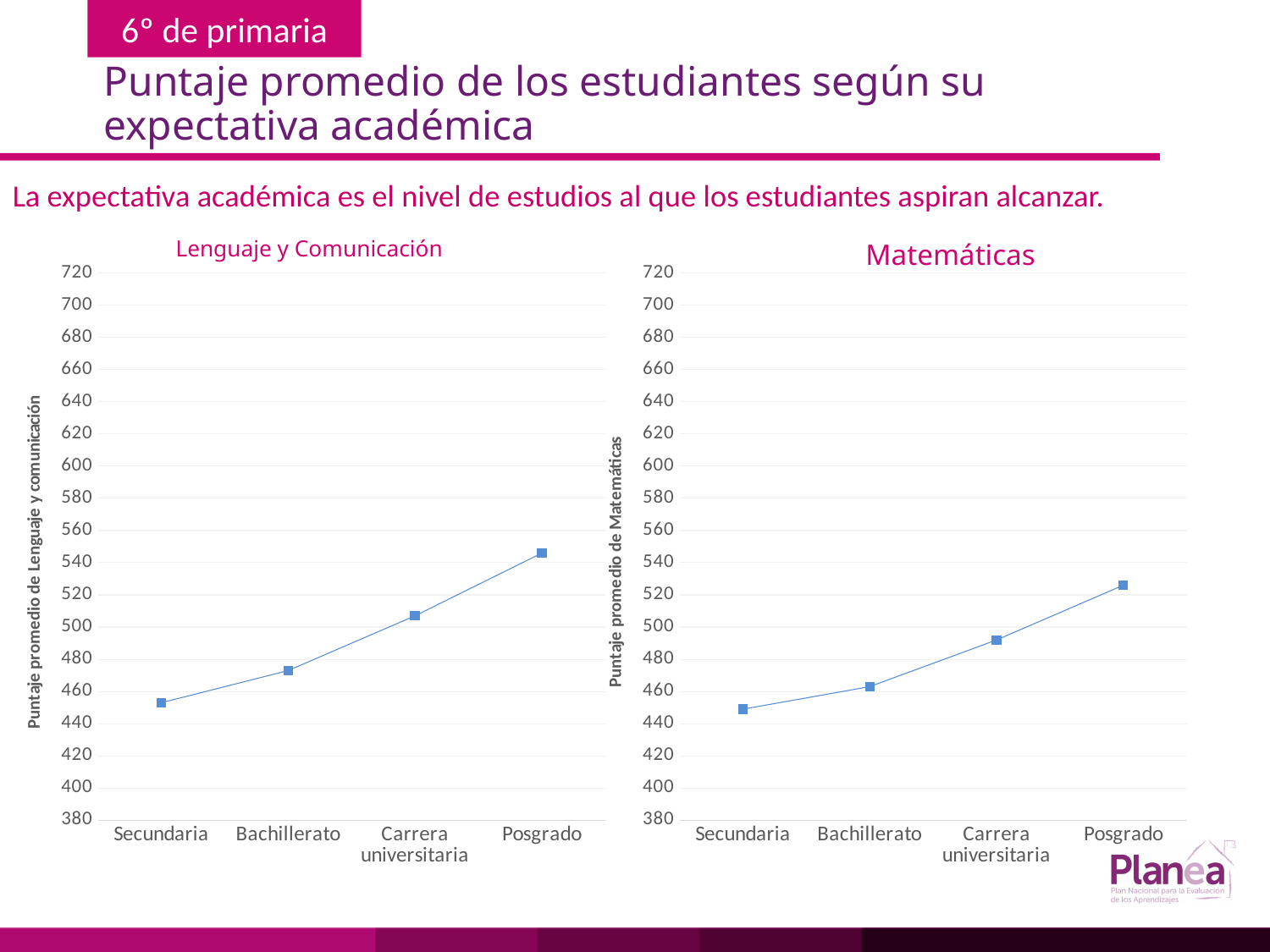
What kind of chart is the Lenguaje y Comunicación chart? line chart In the Matemáticas chart, is the value for Carrera universitaria greater or less than 480? greater What is the y-axis label of the Matemáticas chart? Puntaje promedio de Matemáticas In the Lenguaje y Comunicación chart, which category has the highest score? Posgrado In the Lenguaje y Comunicación chart, do the values rise or fall from Secundaria to Posgrado? rise In the Matemáticas chart, is the value for Posgrado greater or less than 500? greater What is the title of the chart on the right side of the slide? Matemáticas How many categories are shown on the x axis of the Matemáticas chart? 4 In the Matemáticas chart, which category has the lowest score? Secundaria In the Matemáticas chart, which is larger, the value for Secundaria or the value for Posgrado? Posgrado In the Lenguaje y Comunicación chart, which is larger, the value for Bachillerato or the value for Carrera universitaria? Carrera universitaria In the Lenguaje y Comunicación chart, is the value for Secundaria greater or less than 460? less